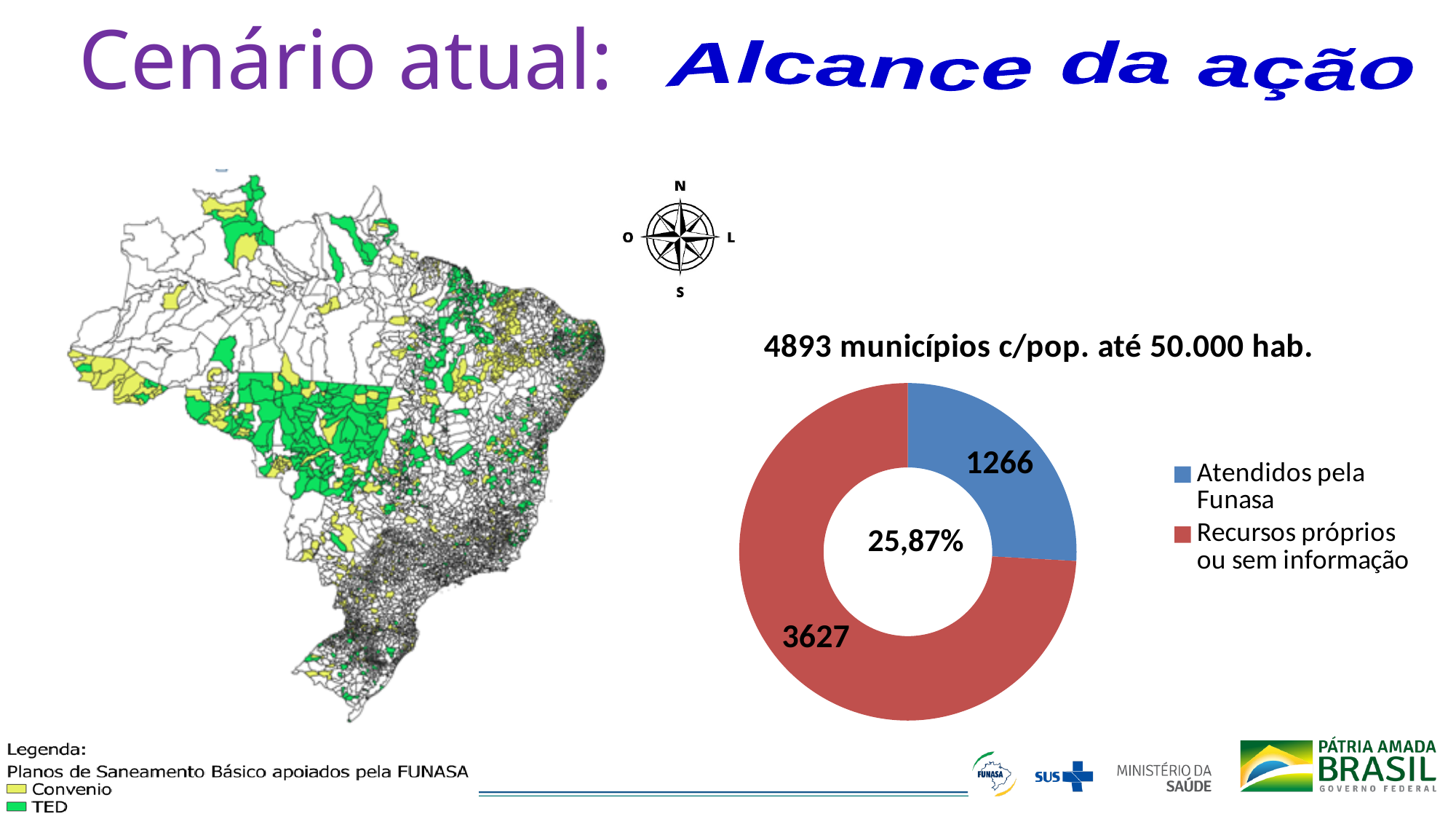
What is the difference between the 'Recursos próprios ou sem informação' value and the 'Atendidos pela Funasa' value in the doughnut chart? 2361 How many categories does the doughnut chart show? 2 In the doughnut chart, how many municipalities are 'Atendidos pela Funasa'? 1266 What is the total number of municipalities represented in the doughnut chart? 4893 Which category in the doughnut chart has the smallest value? Atendidos pela Funasa What colour is the 'Atendidos pela Funasa' slice in the doughnut chart? blue What kind of chart is shown on the right side of the slide? doughnut chart Which category in the doughnut chart has the largest value? Recursos próprios ou sem informação In the doughnut chart, what is the value for 'Recursos próprios ou sem informação'? 3627 In the doughnut chart, which is larger: 'Atendidos pela Funasa' or 'Recursos próprios ou sem informação'? Recursos próprios ou sem informação What share of the doughnut chart does 'Atendidos pela Funasa' represent, as printed in the centre? 25,87% How many entries does the legend of the doughnut chart list? 2